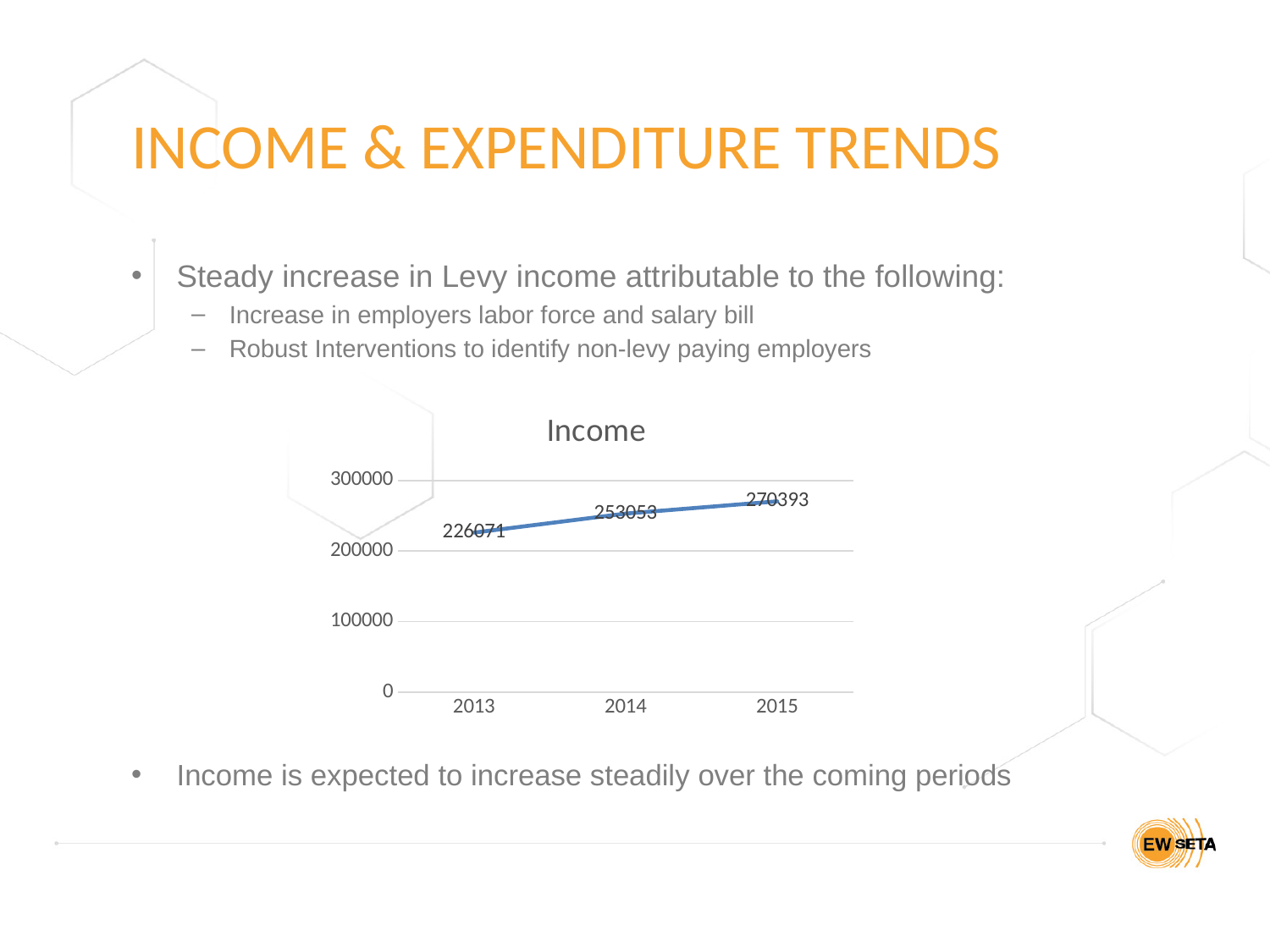
Is the Income for 2014 greater or less than the Income for 2013? greater Is the Income for 2015 greater or less than 300000? less Which year has the lowest Income? 2013 Does Income rise or fall from 2013 to 2015? rise What is the Income value for 2015? 270393 What kind of chart is used to show Income? line chart How many years are plotted on the Income chart? 3 What is the difference in Income between 2015 and 2013? 44322 What is the Income value for 2014? 253053 What is the difference in Income between 2014 and 2013? 26982 Which year has the highest Income? 2015 What is the Income value for 2013? 226071